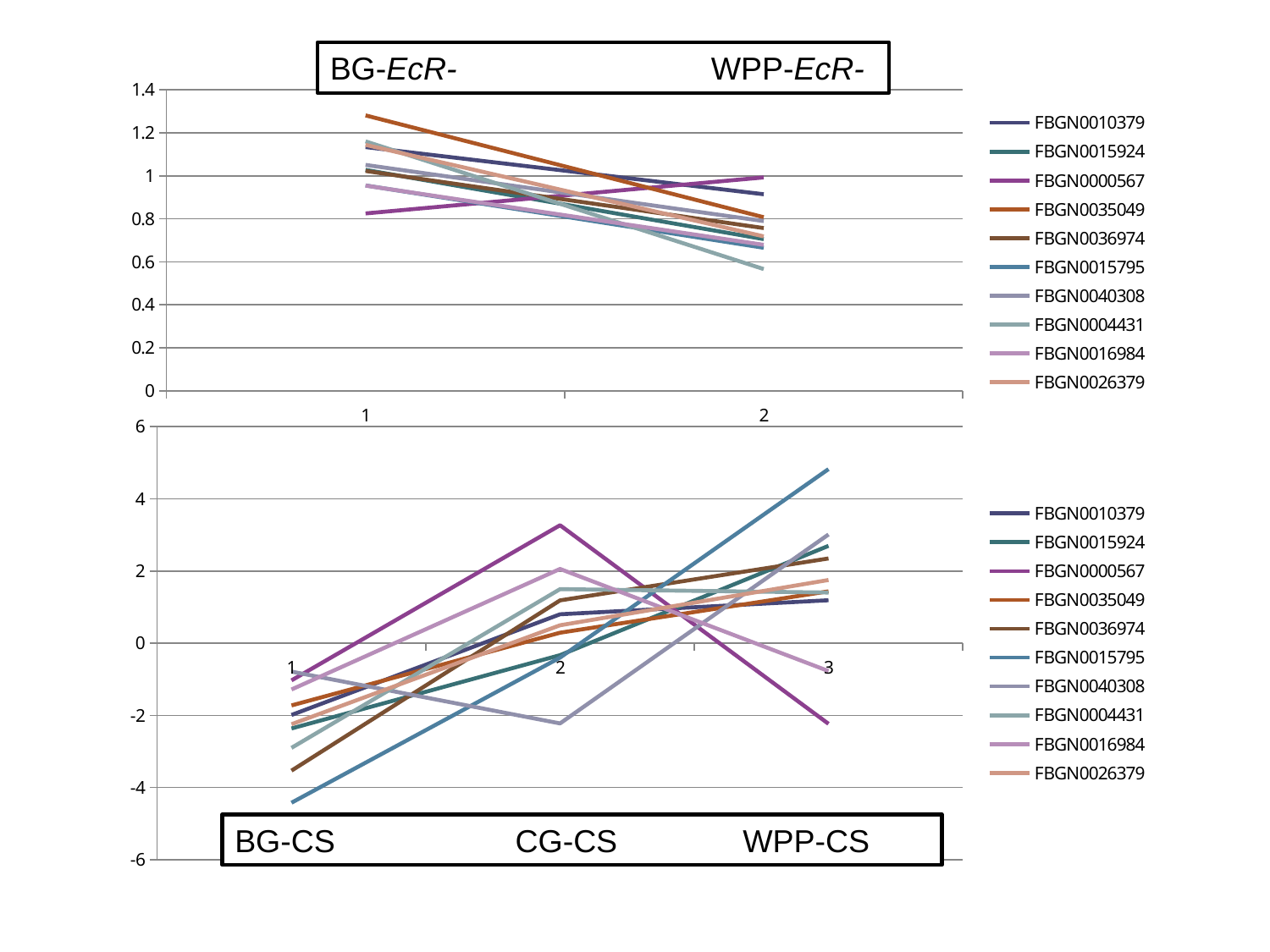
In the top chart, does FBGN0000567 rise or fall from point 1 to point 2? rise In the top chart, is the value of FBGN0035049 at point 1 greater or less than 1.2? greater How many series does the legend of the bottom chart list? 10 In the bottom chart, which series has the highest value at point 3? FBGN0015795 In the bottom chart, which series has the lowest value at point 2? FBGN0040308 How many points are on the x axis of the top chart? 2 In the bottom chart, which series has the lowest value at point 1? FBGN0015795 How many points are on the x axis of the bottom chart? 3 In the top chart, which series has the highest value at point 1? FBGN0035049 In the top chart, which series has the lowest value at point 2? FBGN0004431 In the bottom chart, is the value of FBGN0000567 at point 2 greater or less than 2? greater What kind of chart is the top chart on the slide? line chart